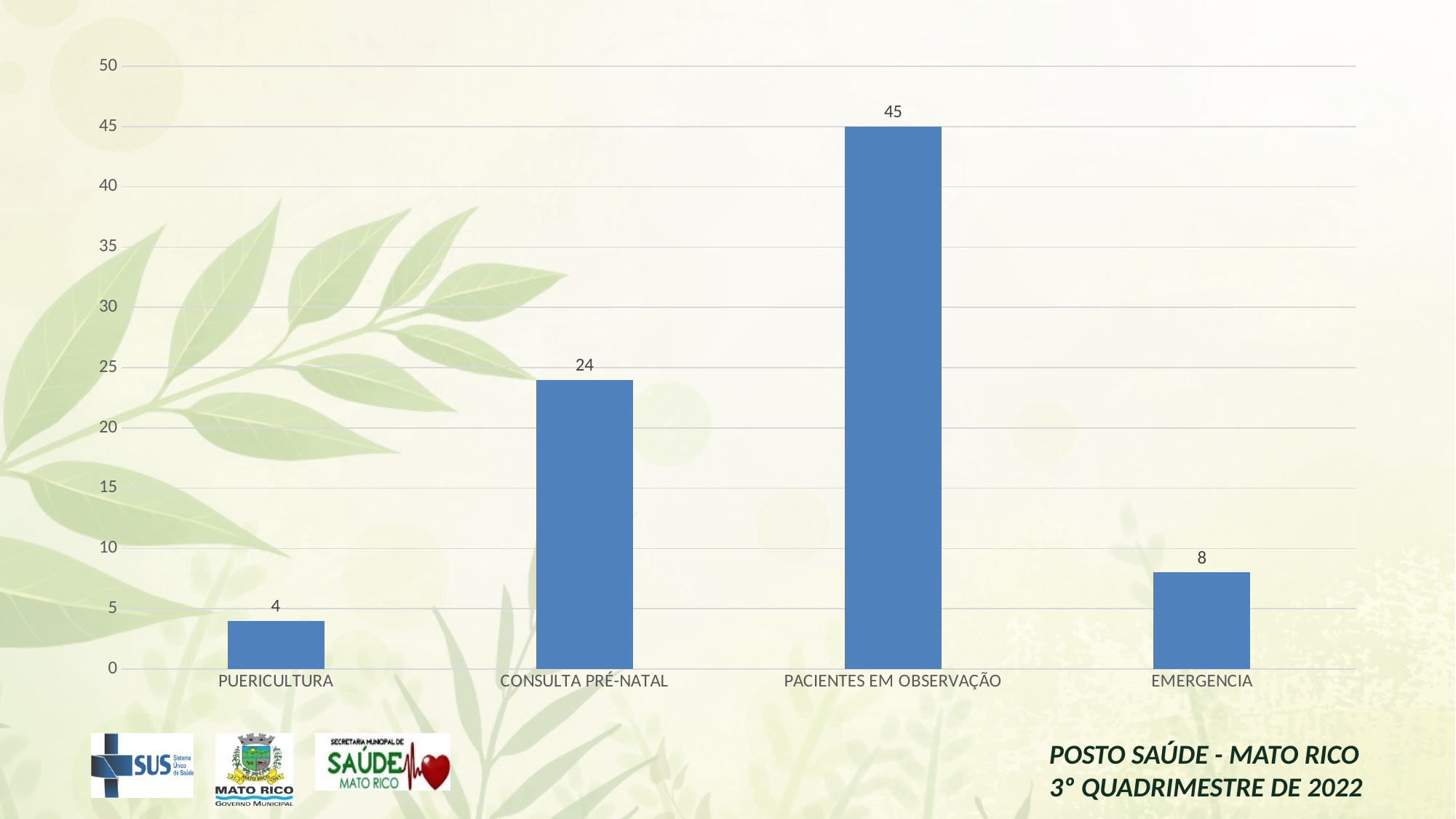
What is the difference between the values for PACIENTES EM OBSERVAÇÃO and CONSULTA PRÉ-NATAL? 21 What kind of chart is shown on the slide? bar chart Is the value for PACIENTES EM OBSERVAÇÃO greater or less than 40? greater What is the difference between the values for EMERGENCIA and PUERICULTURA? 4 What is the value for EMERGENCIA? 8 How many categories are shown in the chart? 4 Which category has the lowest value? PUERICULTURA Which category has the highest value? PACIENTES EM OBSERVAÇÃO What is the value for PUERICULTURA? 4 What is the value for CONSULTA PRÉ-NATAL? 24 Which is larger, the value for CONSULTA PRÉ-NATAL or the value for EMERGENCIA? CONSULTA PRÉ-NATAL What is the value for PACIENTES EM OBSERVAÇÃO? 45